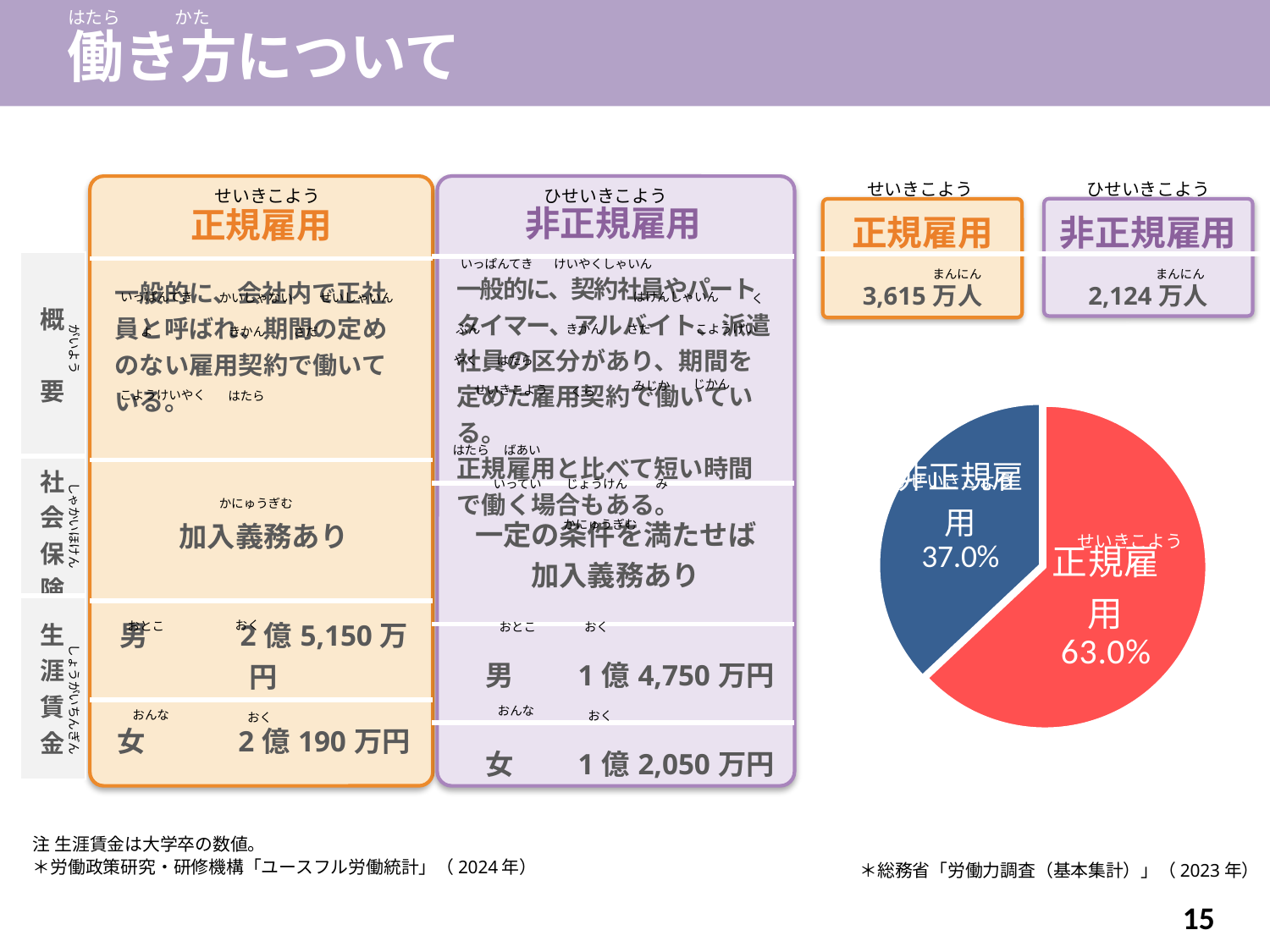
What kind of chart is shown on the right side of the slide? pie chart In the pie chart, which is larger, 正規雇用 or 非正規雇用? 正規雇用 How many slices does the pie chart have? 2 What colour is the 正規雇用 slice in the pie chart? red Which slice of the pie chart is the largest? 正規雇用 What colour is the 非正規雇用 slice in the pie chart? blue What share of the pie chart does 正規雇用 account for? 63.0% What share of the pie chart does 非正規雇用 account for? 37.0% Is the share for 正規雇用 in the pie chart greater or less than 50%? greater Is the share for 非正規雇用 in the pie chart greater or less than 50%? less In the pie chart, by how many percentage points does 正規雇用 exceed 非正規雇用? 26.0 percentage points Which slice of the pie chart is the smallest? 非正規雇用